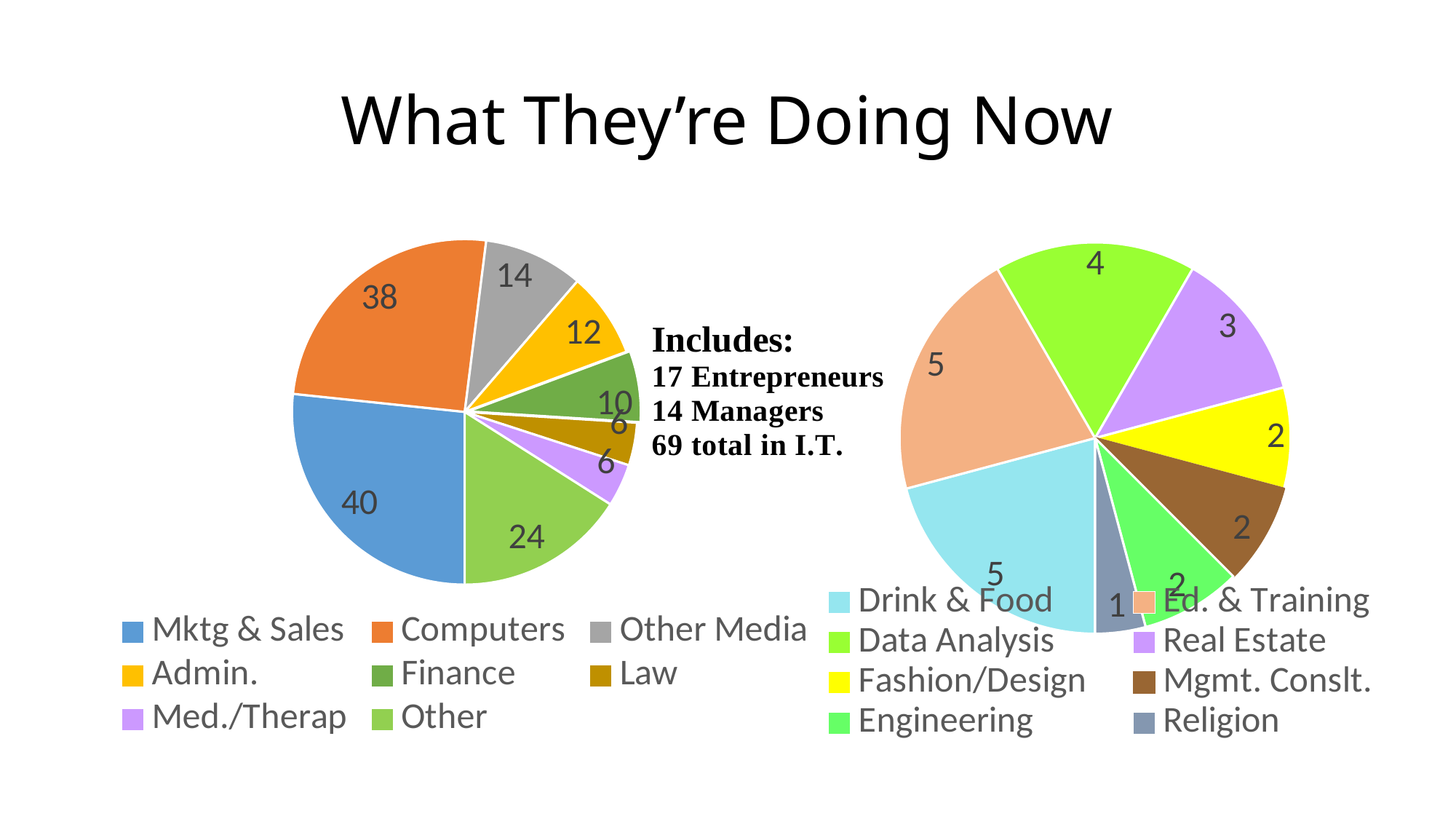
In the right pie chart, what is the value for Religion? 1 In the right pie chart, which category has the smallest slice? Religion In the right pie chart, what is the value for Data Analysis? 4 What is the title of the slide? What They're Doing Now In the left pie chart, which category has the largest slice? Mktg & Sales In the left pie chart, what is the value for Finance? 10 What type of chart is shown on the left of the slide? Pie chart In the left pie chart, what is the difference between the values for Other and Other Media? 10 In the right pie chart, which is larger, Real Estate or Fashion/Design? Real Estate How many categories does the right pie chart's legend list? 8 In the left pie chart, what is the value for Mktg & Sales? 40 In the left pie chart, what is the value for Computers? 38